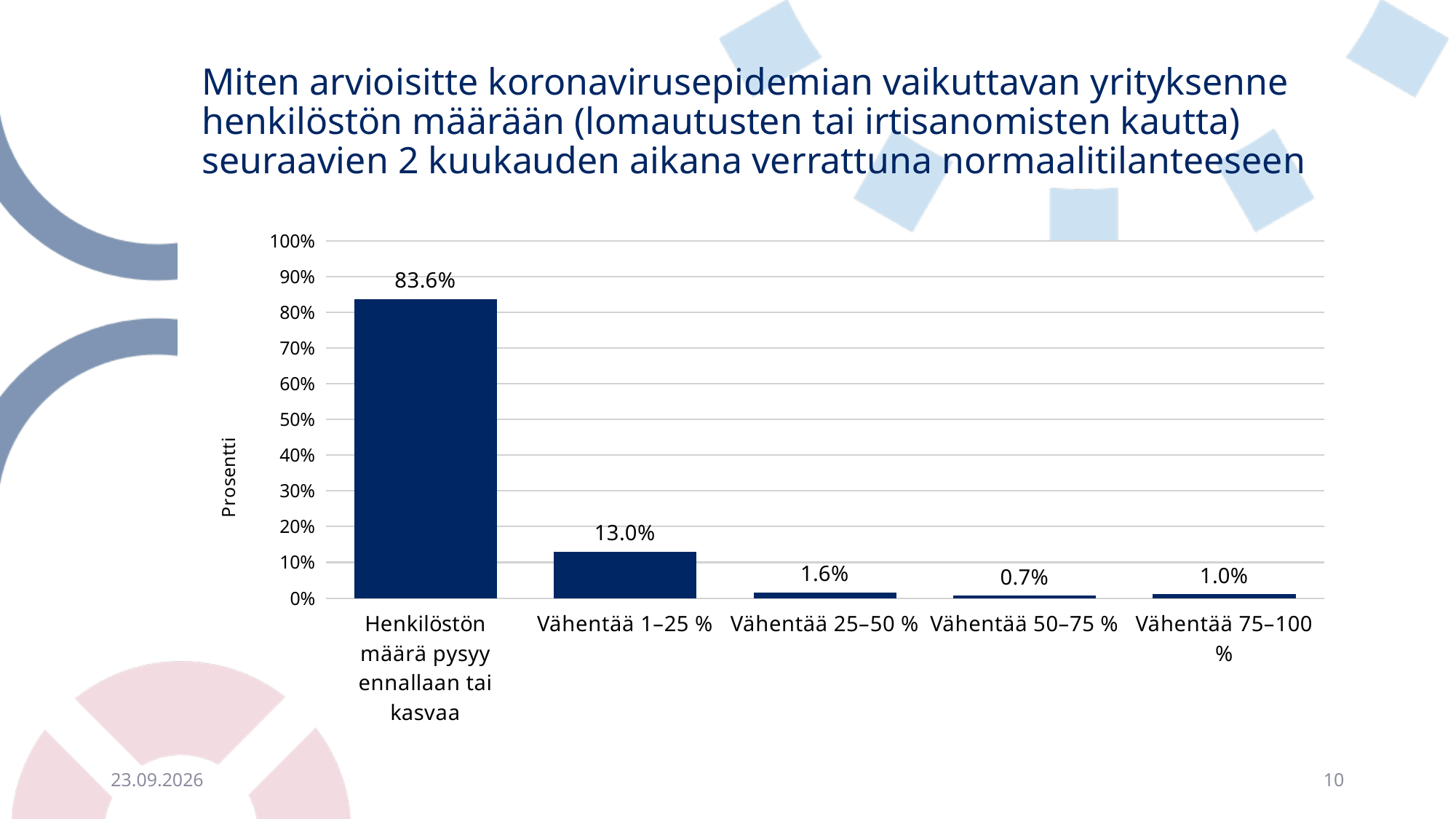
What kind of chart is shown on the slide? Bar chart What is the value for "Vähentää 1–25 %"? 13.0% What is the value for "Vähentää 50–75 %"? 0.7% What is the value for "Vähentää 25–50 %"? 1.6% What is the label of the vertical axis? Prosentti What is the difference between the values for "Henkilöstön määrä pysyy ennallaan tai kasvaa" and "Vähentää 1–25 %"? 70.6% How many categories are shown on the x axis? 5 Which is larger, the value for "Vähentää 25–50 %" or "Vähentää 75–100 %"? Vähentää 25–50 % Which category has the lowest value? Vähentää 50–75 % What is the value for "Henkilöstön määrä pysyy ennallaan tai kasvaa"? 83.6% What is the value for "Vähentää 75–100 %"? 1.0% Which category has the highest value? Henkilöstön määrä pysyy ennallaan tai kasvaa